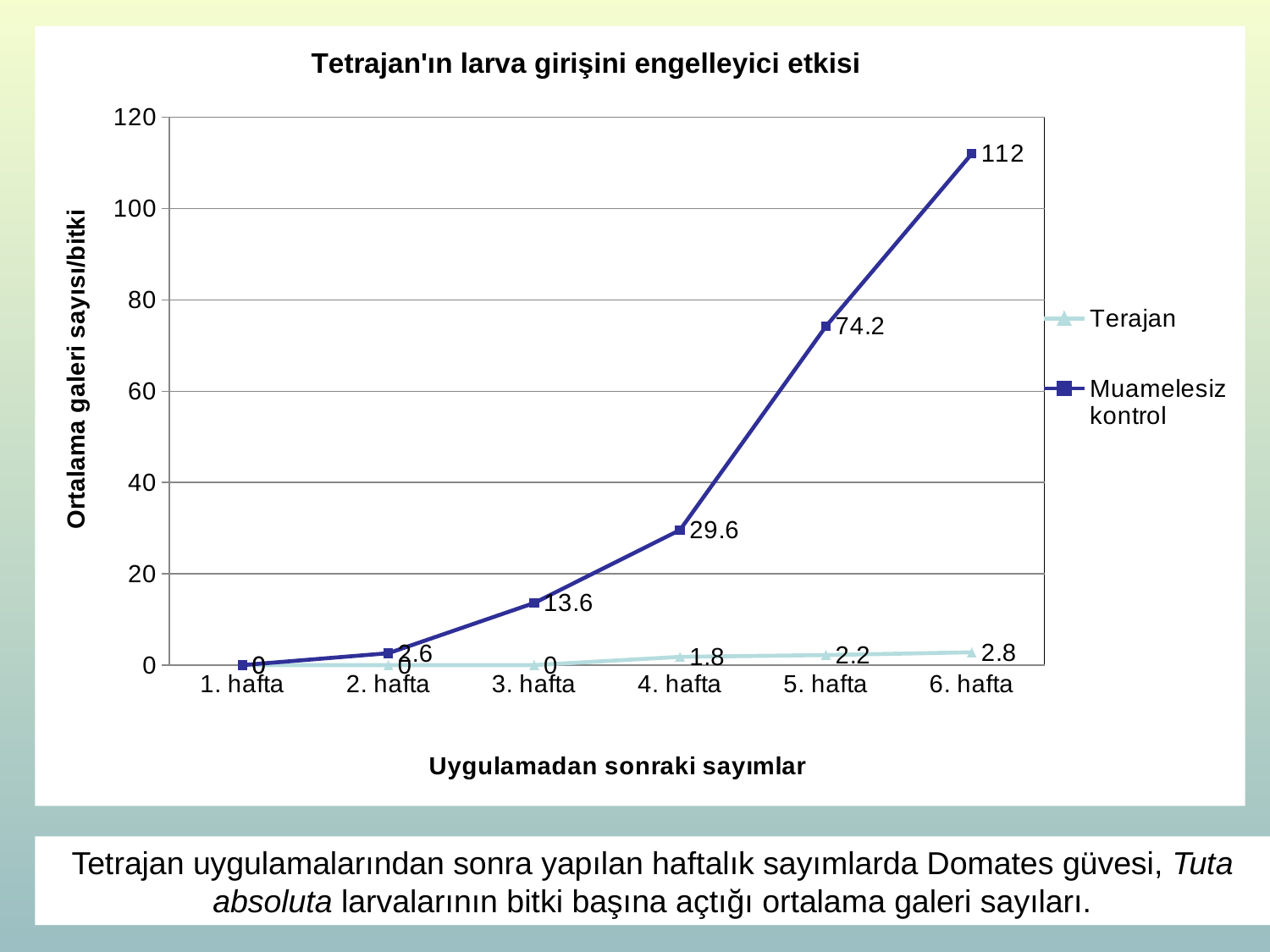
What is the value for Muamelesiz kontrol at 4. hafta? 29.6 What is the title of the chart? Tetrajan'ın larva girişini engelleyici etkisi What is the difference between Muamelesiz kontrol and Terajan at 6. hafta? 109.2 Does the Muamelesiz kontrol series rise or fall from 1. hafta to 6. hafta? rise What type of chart is shown on the slide? line chart How many series does the legend list? 2 What is the value for Muamelesiz kontrol at 6. hafta? 112 Which series has the larger value at 5. hafta, Terajan or Muamelesiz kontrol? Muamelesiz kontrol At which week does Muamelesiz kontrol reach its highest value? 6. hafta What is the label of the y axis? Ortalama galeri sayısı/bitki How many weeks (categories) are shown on the x axis? 6 What is the value for Terajan at 5. hafta? 2.2